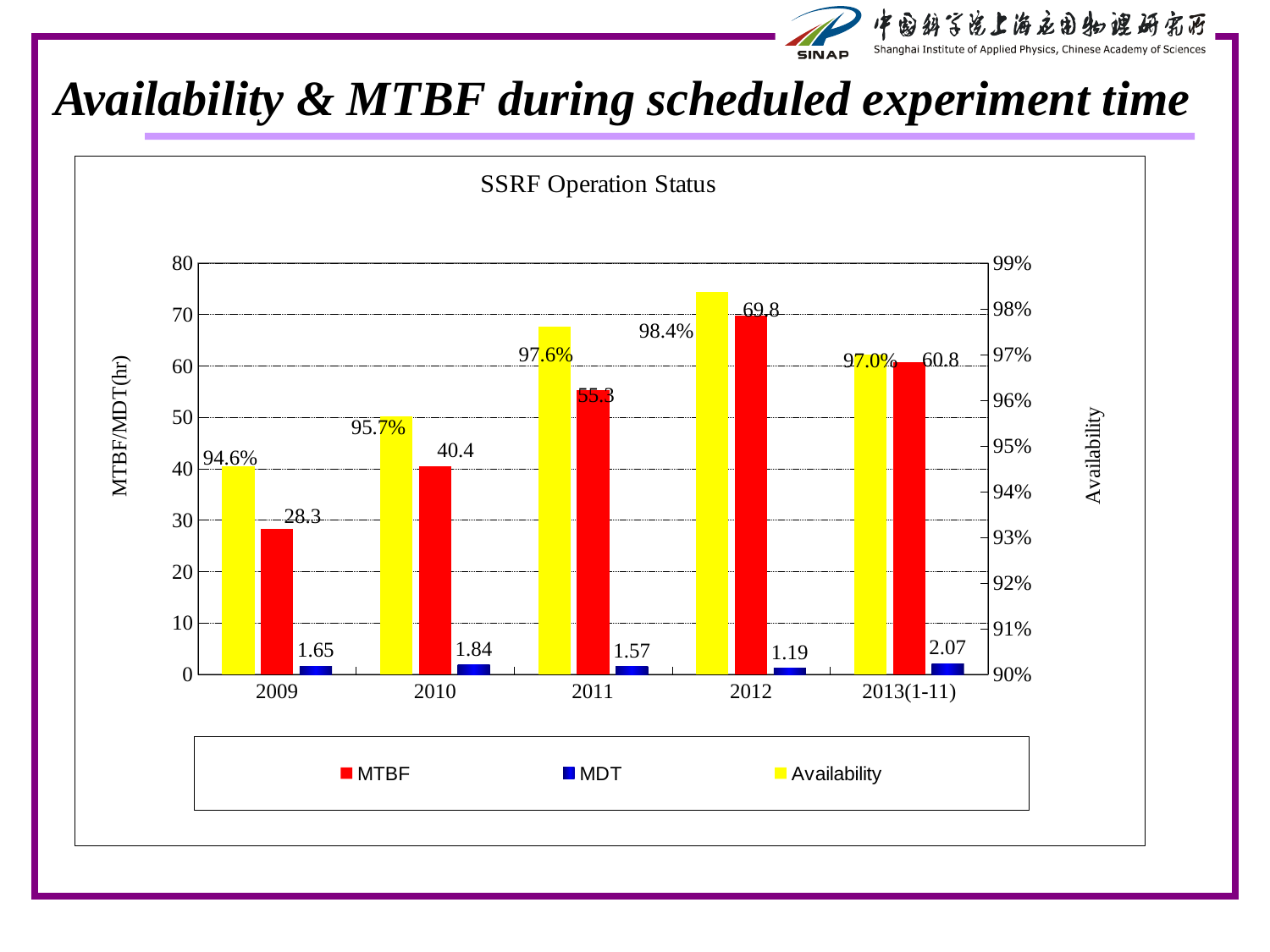
What kind of chart is this? Bar chart Is the Availability for 2012 greater or less than 98%? greater Which year has the lowest MDT? 2012 What is the Availability value for 2010? 95.7% What is the MTBF value for 2012? 69.8 How many series does the legend list? 3 What is the difference between the MTBF values for 2012 and 2009? 41.5 Is the MTBF for 2010 larger than the MTBF for 2013(1-11)? No What is the MDT value for 2013(1-11)? 2.07 Which year has the lowest Availability? 2009 Which year has the highest MTBF? 2012 How many years are shown on the x axis? 5